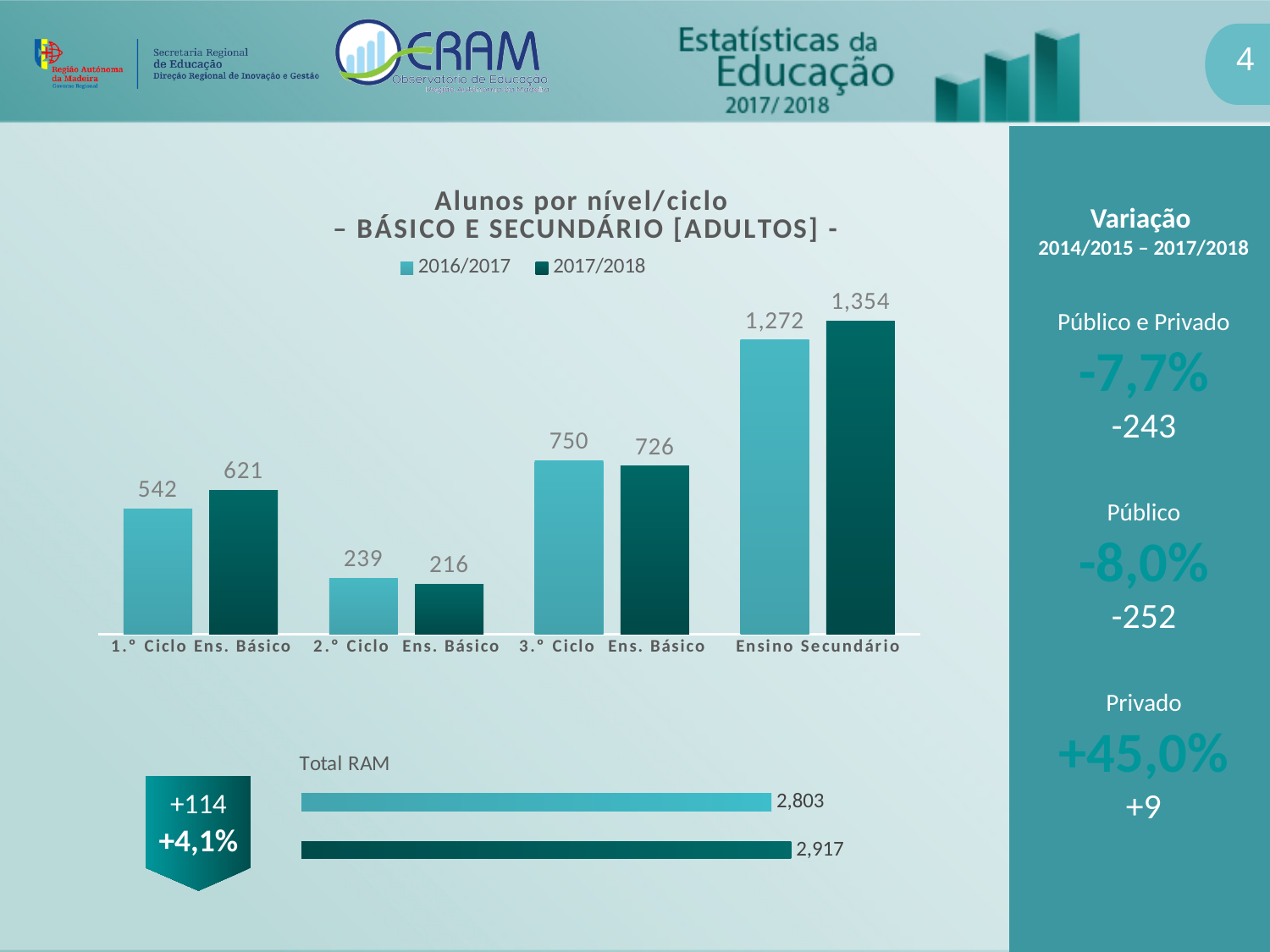
What kind of chart is 'Alunos por nível/ciclo – BÁSICO E SECUNDÁRIO [ADULTOS]'? Bar chart In the chart 'Alunos por nível/ciclo – BÁSICO E SECUNDÁRIO [ADULTOS]', which category has the highest value in 2016/2017? Ensino Secundário In the chart 'Alunos por nível/ciclo – BÁSICO E SECUNDÁRIO [ADULTOS]', what is the value for Ensino Secundário in 2017/2018? 1,354 In the 'Total RAM' chart at the bottom of the slide, what is the value of the darker (2017/2018) bar? 2,917 How many series does the legend of the chart 'Alunos por nível/ciclo – BÁSICO E SECUNDÁRIO [ADULTOS]' list? 2 In the chart 'Alunos por nível/ciclo – BÁSICO E SECUNDÁRIO [ADULTOS]', what is the value for 2.º Ciclo Ens. Básico in 2016/2017? 239 In the chart 'Alunos por nível/ciclo – BÁSICO E SECUNDÁRIO [ADULTOS]', which is larger for 1.º Ciclo Ens. Básico: 2016/2017 or 2017/2018? 2017/2018 In the chart 'Alunos por nível/ciclo – BÁSICO E SECUNDÁRIO [ADULTOS]', what is the difference between the 2017/2018 and 2016/2017 values for 3.º Ciclo Ens. Básico? 24 In the chart 'Alunos por nível/ciclo – BÁSICO E SECUNDÁRIO [ADULTOS]', what is the value for 1.º Ciclo Ens. Básico in 2017/2018? 621 How many categories are shown on the x axis of the chart 'Alunos por nível/ciclo – BÁSICO E SECUNDÁRIO [ADULTOS]'? 4 In the 'Total RAM' chart at the bottom of the slide, what is the difference between the two bars? 114 In the chart 'Alunos por nível/ciclo – BÁSICO E SECUNDÁRIO [ADULTOS]', which category has the lowest value in 2017/2018? 2.º Ciclo Ens. Básico